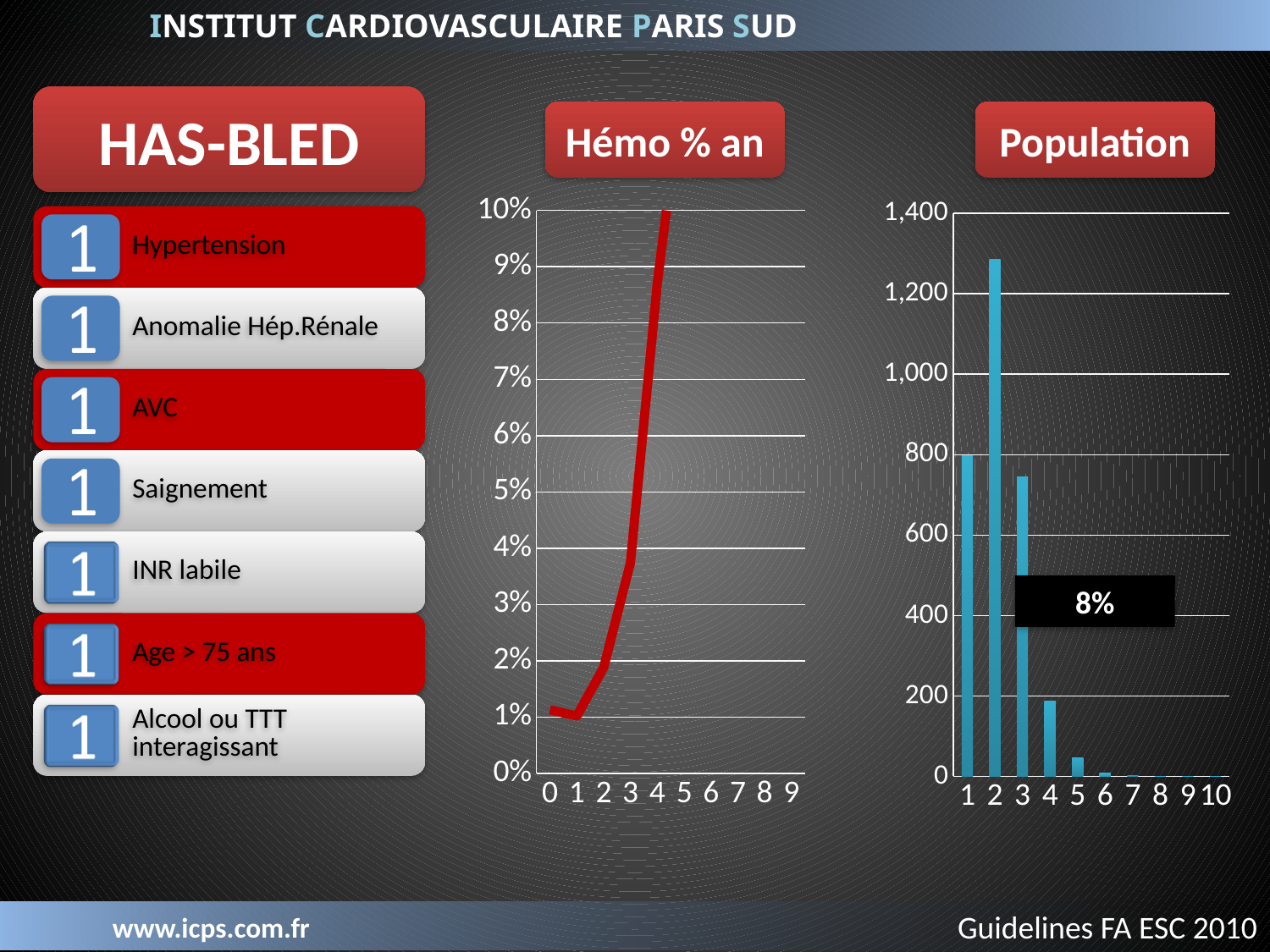
In the "Population" chart, is the bar for score 3 greater or less than 800? less In the "Population" chart, which bar is taller, score 1 or score 3? score 1 What kind of chart is the "Hémo % an" chart? line chart In the "Hémo % an" chart, is the value at score 3 greater or less than 3%? greater In the "Population" chart, is the bar for score 2 greater or less than 1,200? greater In the "Population" chart, which score has the highest bar? 2 What kind of chart is the "Population" chart? bar chart How many score categories are shown on the x axis of the "Population" chart? 10 In the "Hémo % an" chart, do the values rise or fall as the score increases along the x axis? rise